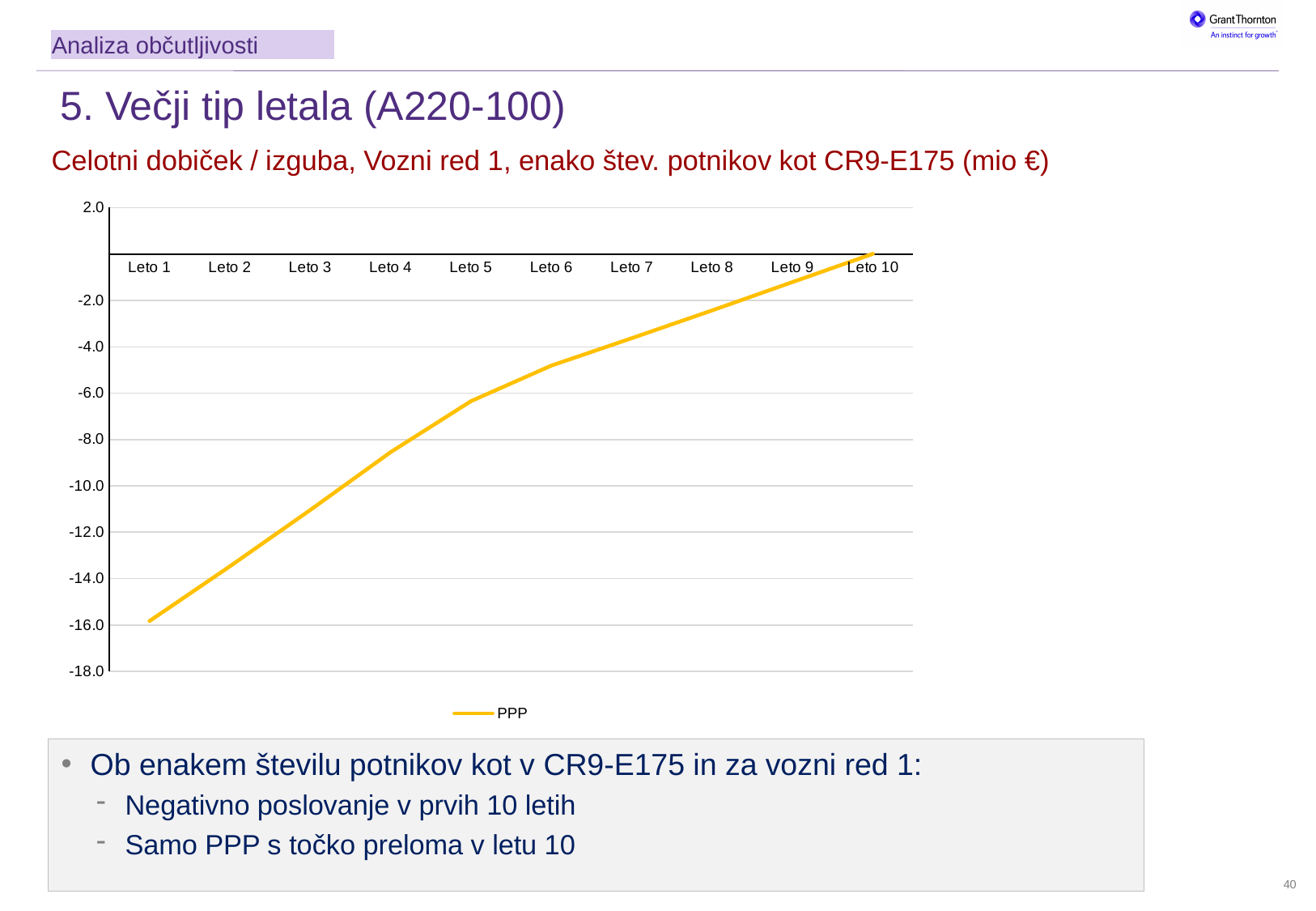
Is the value for Leto 9 greater or less than -2.0? greater Which year has the highest value for PPP? Leto 10 Which year has the lowest value for PPP? Leto 1 Do the PPP values rise or fall from Leto 1 to Leto 10? rise Which is larger, the value for Leto 1 or the value for Leto 5? Leto 5 Is the value for Leto 2 greater or less than -12.0? less How many years (categories) are plotted on the x axis? 10 What is the name of the series shown in the legend? PPP Is the value for Leto 1 greater or less than -14.0? less What kind of chart is shown on the slide? line chart How many series does the legend list? 1